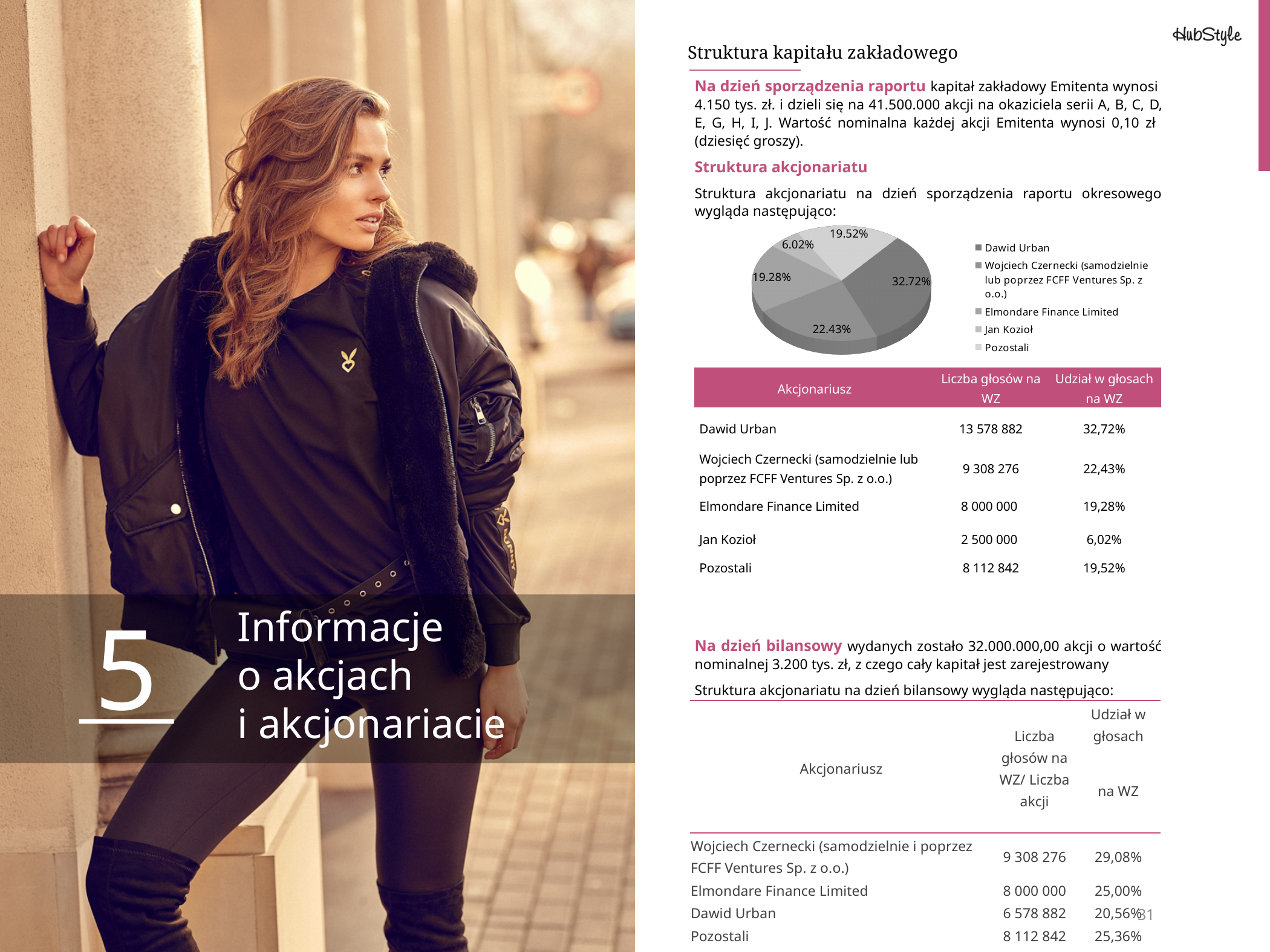
What is the value shown for Pozostali in the pie chart? 19.52% Which legend entry is listed first in the pie chart's legend? Dawid Urban How many slices does the pie chart have? 5 What share of the pie chart does Dawid Urban hold? 32.72% In the pie chart, which is larger: the slice for Elmondare Finance Limited or the slice for Jan Kozioł? Elmondare Finance Limited Which shareholder has the smallest slice in the pie chart? Jan Kozioł What is the difference in percentage points between Dawid Urban's slice and Wojciech Czernecki's slice in the pie chart? 10.29 What is the value shown for Jan Kozioł in the pie chart? 6.02% How many entries does the pie chart's legend list? 5 What is the value shown for Elmondare Finance Limited in the pie chart? 19.28% What kind of chart is shown on the slide? pie chart Which shareholder has the largest slice in the pie chart? Dawid Urban